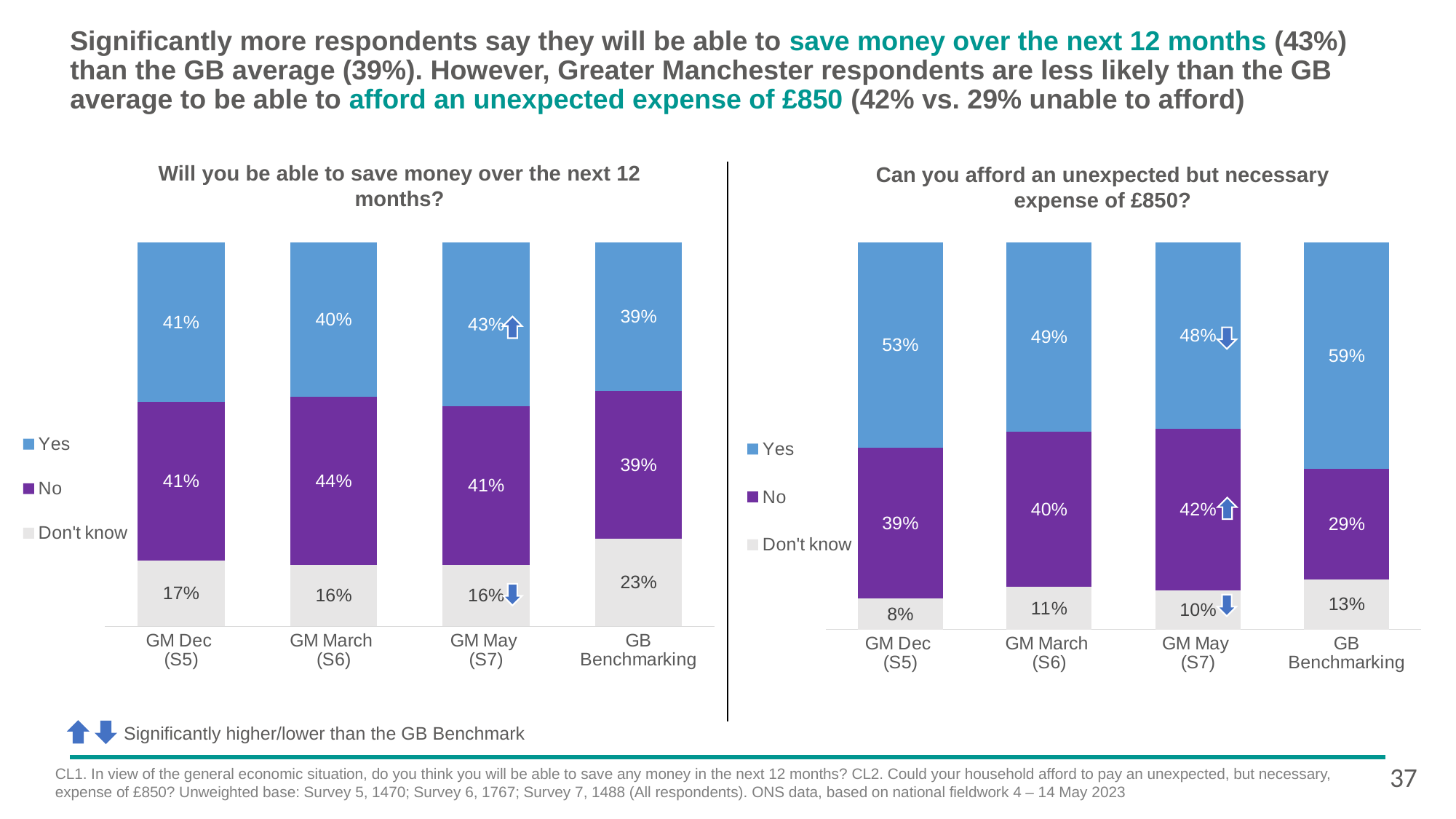
In the chart 'Can you afford an unexpected but necessary expense of £850?', which category has the lowest 'Don't know' value? GM Dec (S5) In the chart 'Can you afford an unexpected but necessary expense of £850?', what is the difference between the 'Yes' values for GB Benchmarking and GM Dec (S5)? 6% In the chart 'Will you be able to save money over the next 12 months?', what is the 'Yes' value for GM May (S7)? 43% What type of chart is 'Will you be able to save money over the next 12 months?'? Stacked bar chart In the chart 'Will you be able to save money over the next 12 months?', which category has the highest 'No' value? GM March (S6) How many series does the legend list in the chart 'Can you afford an unexpected but necessary expense of £850?'? 3 In the chart 'Can you afford an unexpected but necessary expense of £850?', what is the 'No' value for GM May (S7)? 42% In the chart 'Will you be able to save money over the next 12 months?', what is the difference between the 'Don't know' values for GB Benchmarking and GM Dec (S5)? 6% In the chart 'Will you be able to save money over the next 12 months?', what is the 'Don't know' value for GB Benchmarking? 23% In the chart 'Can you afford an unexpected but necessary expense of £850?', what is the 'Yes' value for GB Benchmarking? 59% In the chart 'Can you afford an unexpected but necessary expense of £850?', which is larger: the 'No' value for GM May (S7) or for GB Benchmarking? GM May (S7) How many categories are shown on the x axis of the chart 'Will you be able to save money over the next 12 months?'? 4